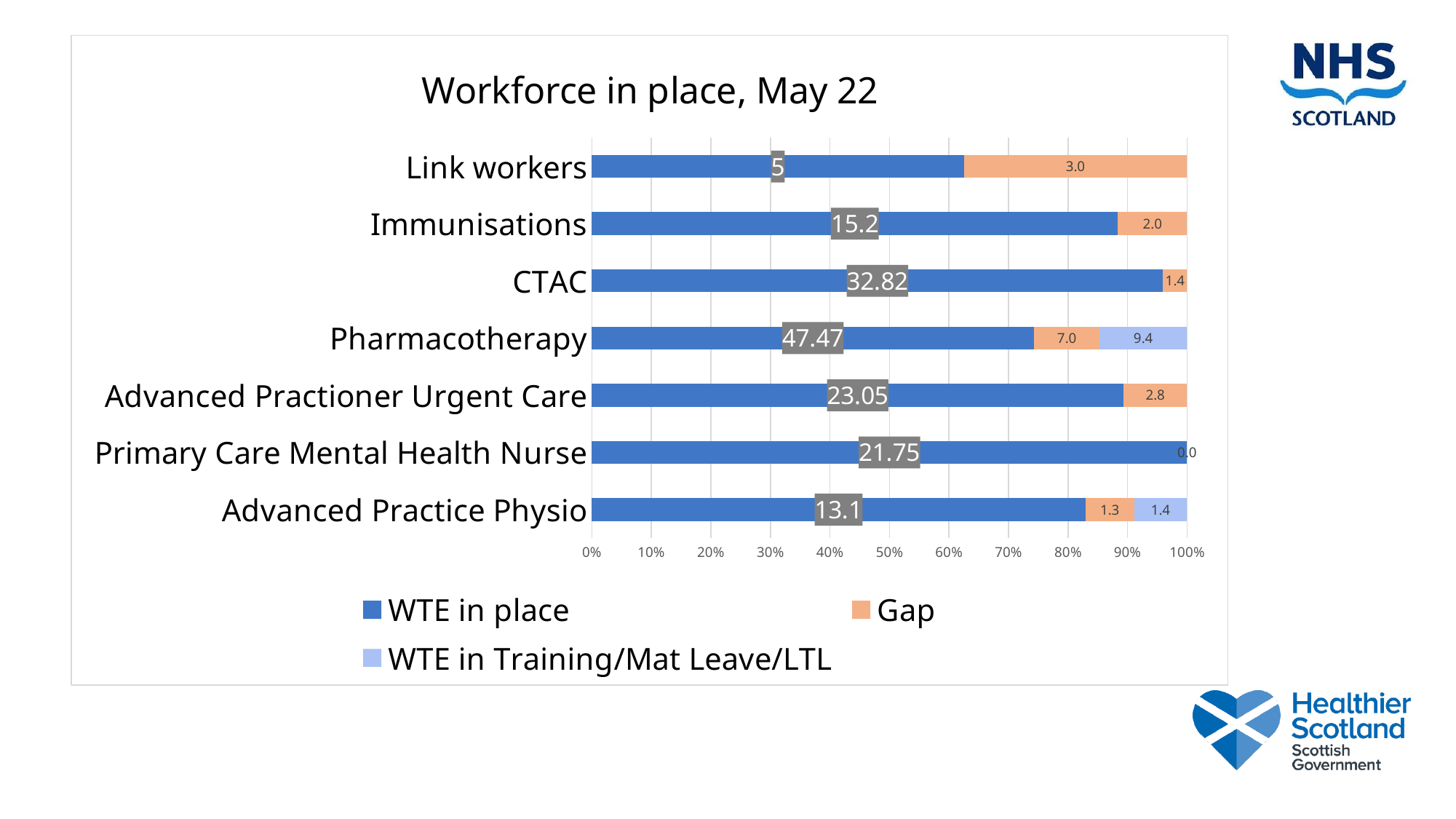
What is the total of the Pharmacotherapy bar across all three series? 63.87 Which category has the lowest WTE in place value? Link workers How many categories are shown on the chart? 7 What is the Gap value for Link workers? 3.0 What is the difference between the WTE in place values for CTAC and Immunisations? 17.62 What is the WTE in place value for Pharmacotherapy? 47.47 What is the WTE in Training/Mat Leave/LTL value for Advanced Practice Physio? 1.4 Is the WTE in place share of the Immunisations bar greater or less than 80%? greater How many series does the legend list? 3 Which is larger, the WTE in place value for Advanced Practioner Urgent Care or for Primary Care Mental Health Nurse? Advanced Practioner Urgent Care Which category has the highest WTE in place value? Pharmacotherapy Which category has the largest Gap value? Pharmacotherapy